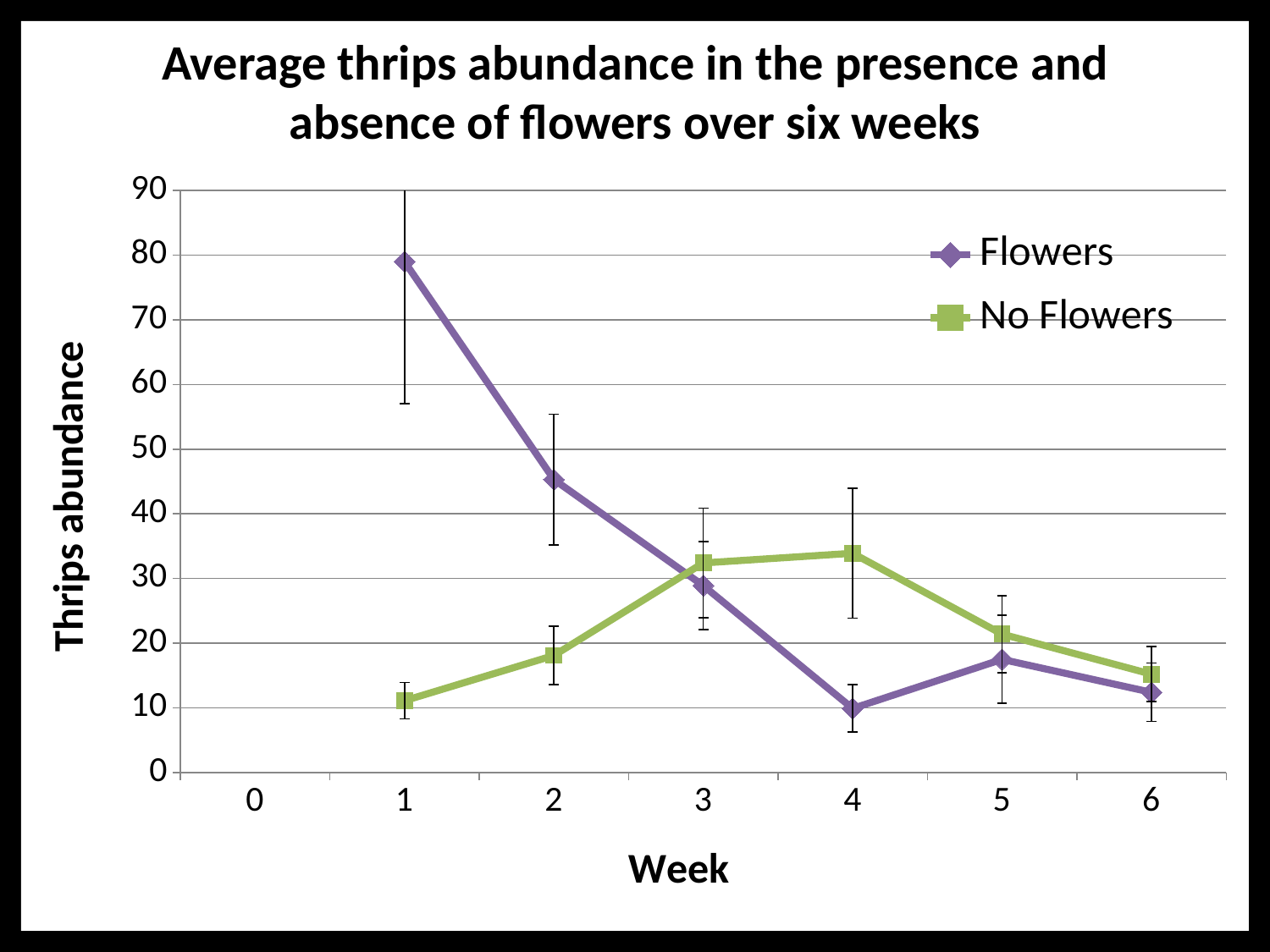
How many weeks have data points plotted for each series? 6 Is the value for Flowers at week 2 greater or less than 50? less How many series does the legend list? 2 Is the value for No Flowers at week 4 greater or less than 30? greater Is the value for Flowers at week 1 greater or less than 70? greater Does the Flowers series rise or fall from week 1 to week 4? fall At which week is the No Flowers series lowest? Week 1 At which week is the Flowers series highest? Week 1 What kind of chart is shown on the slide? line chart What is the title of the y axis? Thrips abundance At week 1, which series has the larger value, Flowers or No Flowers? Flowers